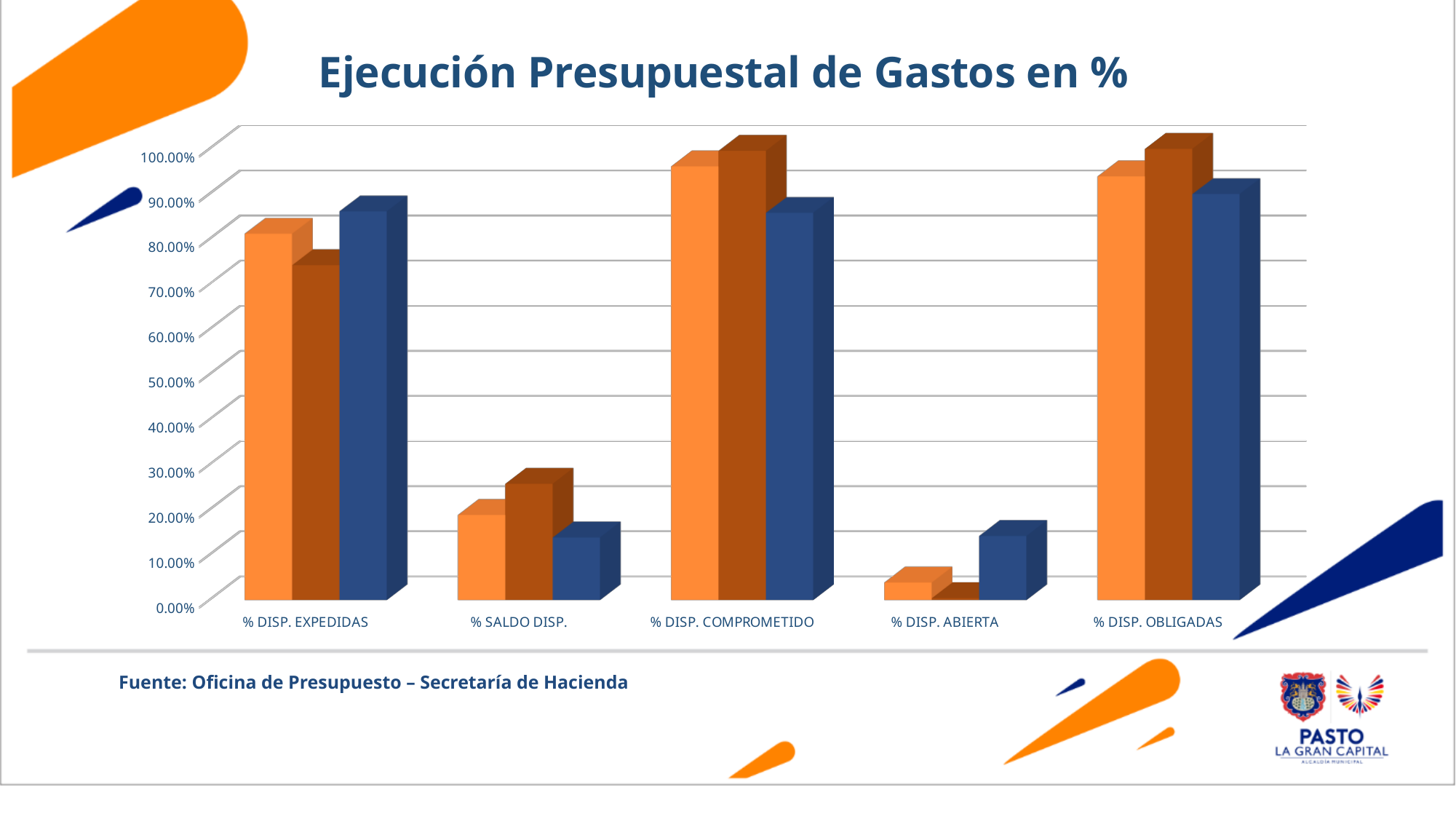
Is the light orange bar for % SALDO DISP. greater or less than 50.00%? less Which category has the lowest bars overall in the chart? % DISP. ABIERTA How many categories are shown on the x axis of the chart? 5 In the % DISP. ABIERTA category, which is larger: the blue bar or the light orange bar? the blue bar What is the title of the chart? Ejecución Presupuestal de Gastos en % Which category has the lowest light orange bar? % DISP. ABIERTA Is the light orange bar for % DISP. ABIERTA greater or less than 10.00%? less Is the blue bar for % DISP. EXPEDIDAS greater or less than 50.00%? greater In the % SALDO DISP. category, which is larger: the dark orange bar or the blue bar? the dark orange bar What kind of chart is shown on the slide? bar chart How many bars are plotted for each category in the chart? 3